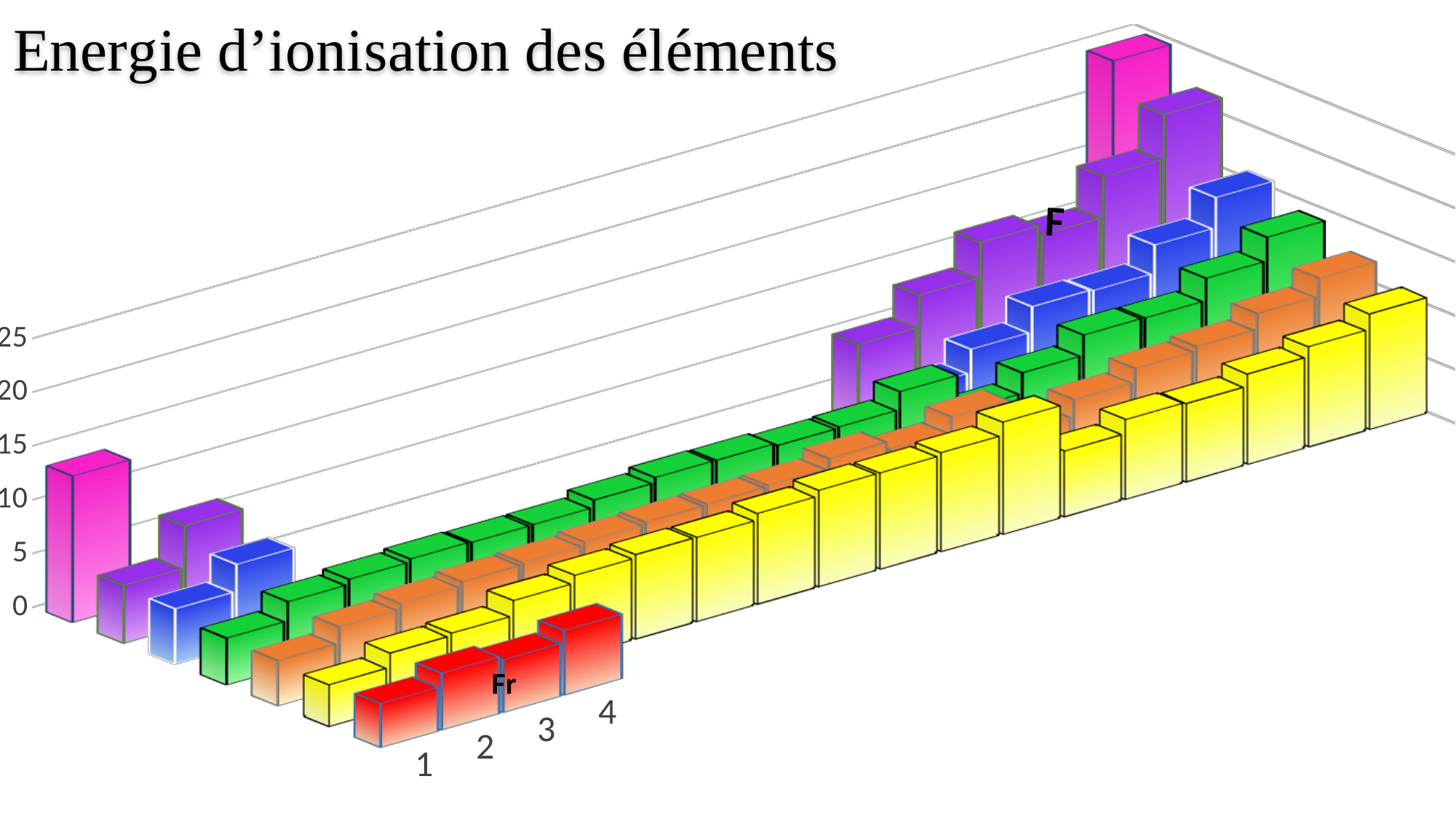
Which labelled element has the lower bar, F or Fr? Fr How many numbered category labels are readable along the front axis of the chart? 4 What is the highest tick value shown on the vertical axis? 25 Which of the two labelled elements, F or Fr, has the taller bar? F Is the value for Fr greater or less than 10? less Is the value for F greater or less than 10? greater What kind of chart is shown on the slide? bar chart What is the title of the chart? Energie d'ionisation des éléments